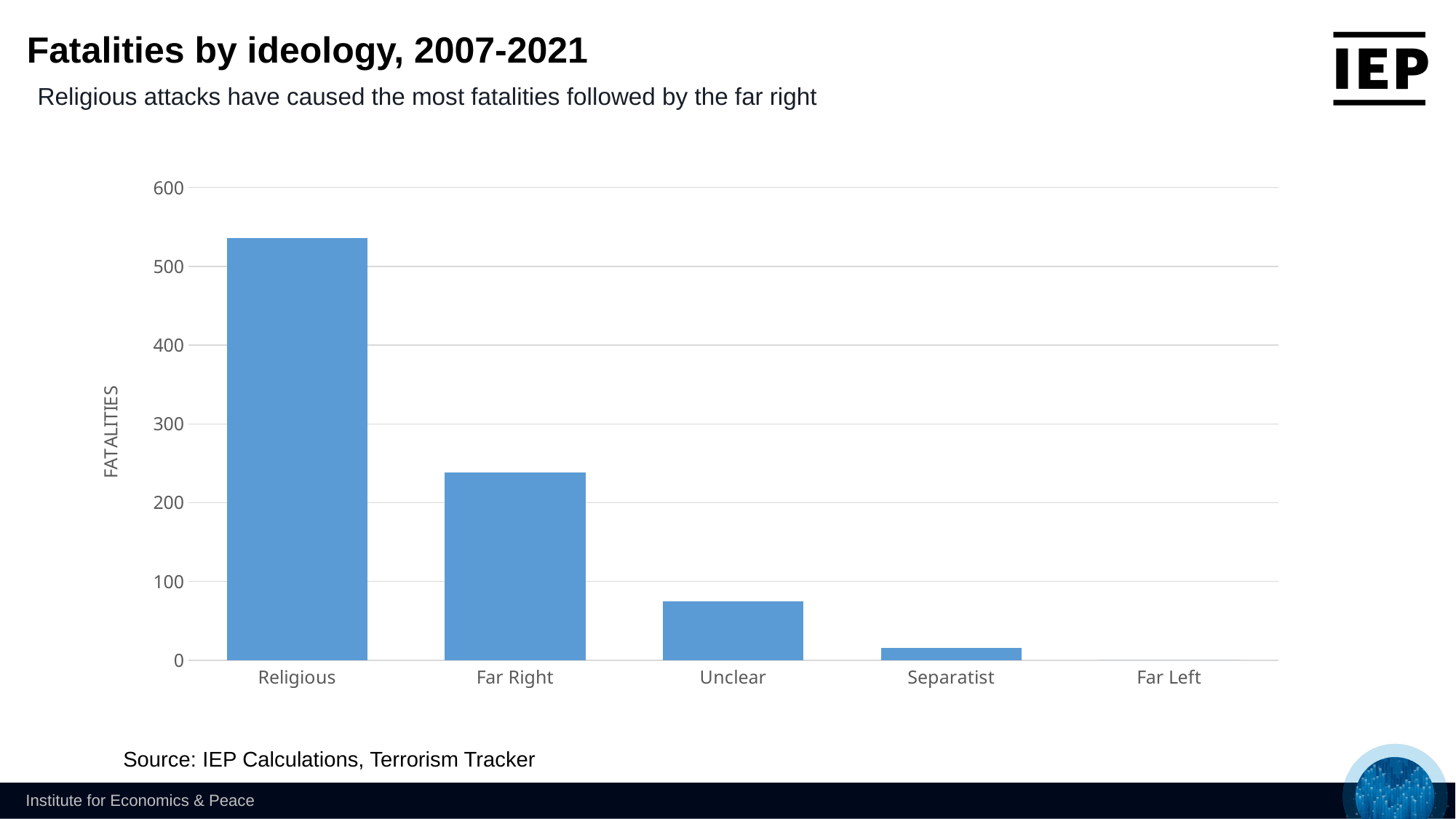
Is the value for Separatist greater or less than 100? less Which has more fatalities, Far Right or Unclear? Far Right What is the label on the y axis? FATALITIES Is the value for Unclear greater or less than 100? less What kind of chart is shown on the slide? bar chart How many ideology categories are shown on the x axis? 5 What is the title of the chart? Fatalities by ideology, 2007-2021 Do the bar values rise or fall moving from left to right along the x axis? fall Which ideology has the lowest number of fatalities? Far Left Is the value for Religious greater or less than 500? greater Which ideology has the highest number of fatalities? Religious